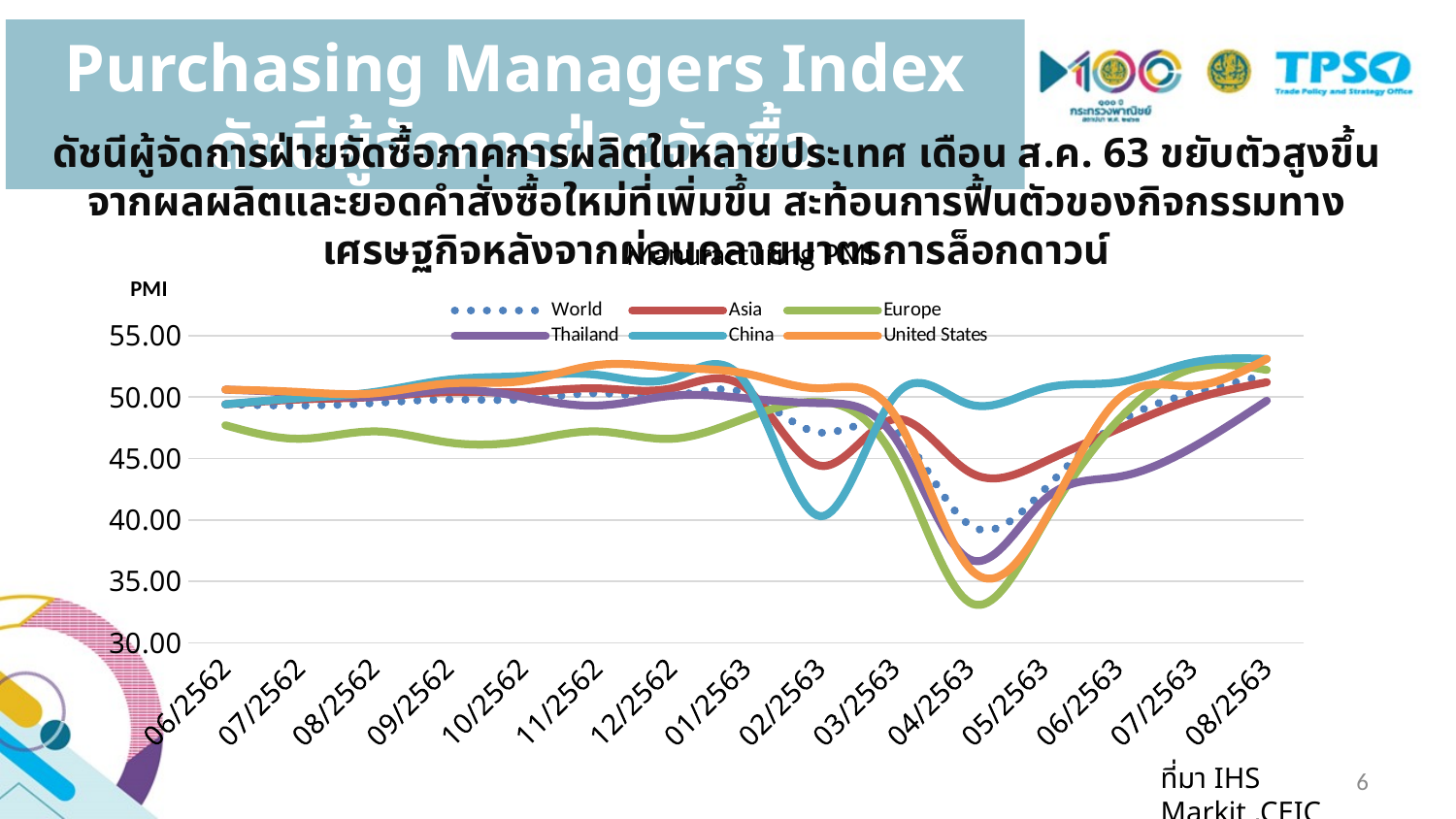
Is the value for China at 04/2563 greater or less than 45.00? greater At 02/2563, which series has the larger value, China or Asia? Asia Is the value for Asia at 04/2563 greater or less than 45.00? less Is the value for Europe at 06/2562 greater or less than 50.00? less Which series has the highest value at 04/2563? China How many time points are shown along the x axis of the chart? 15 What label is shown on the vertical axis of the chart? PMI How many series does the legend of the chart list? 6 What kind of chart is shown on the slide? line chart Which series has the lowest value at 04/2563? Europe Does the Europe series rise or fall from 04/2563 to 08/2563? rise